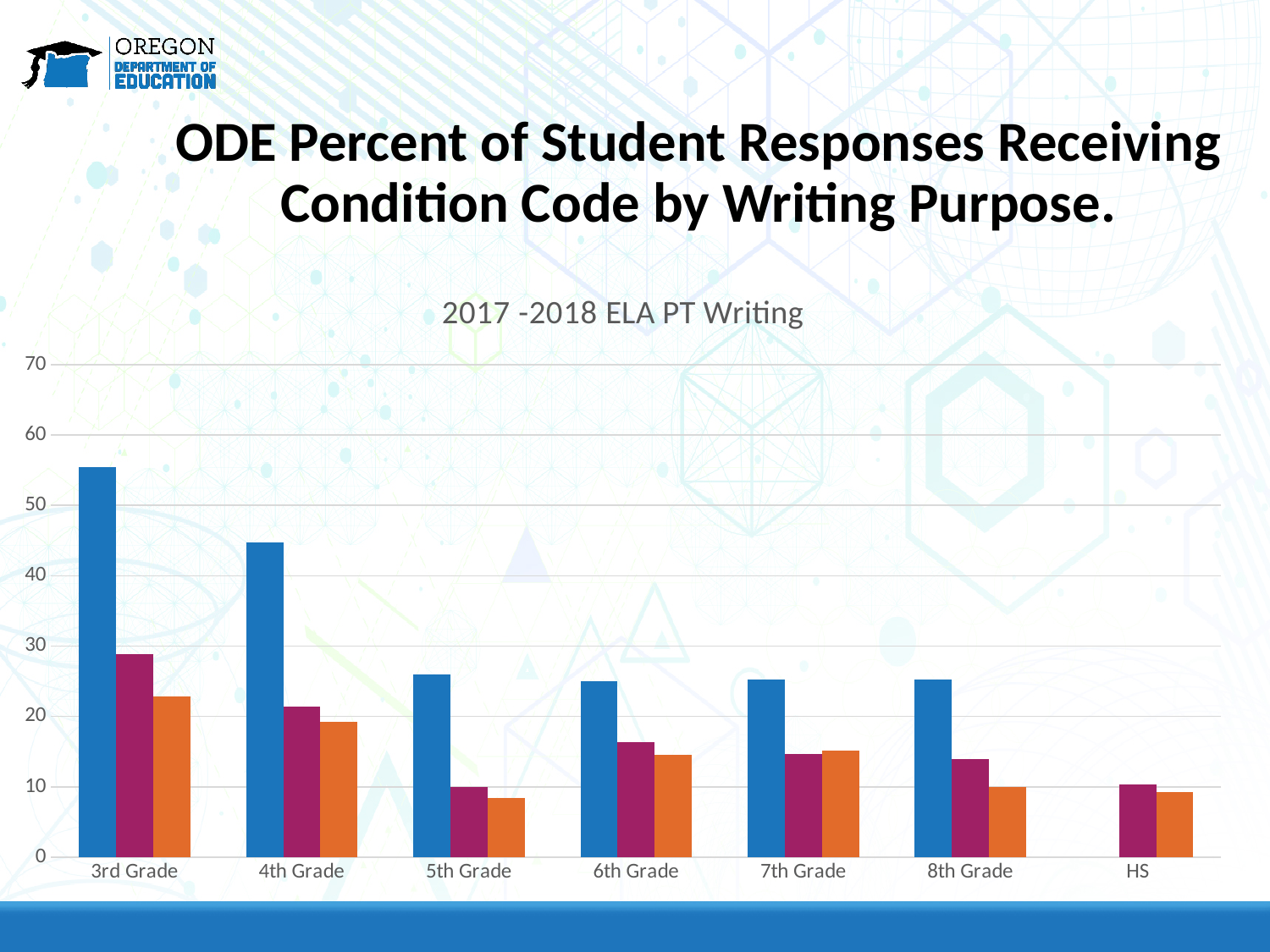
Do the blue bars rise or fall from 3rd Grade to 5th Grade? fall Is the value of the blue bar for 4th Grade greater or less than 40? greater Is the value of the blue bar for 3rd Grade greater or less than 50? greater Which category has no blue bar? HS Is the value of the orange bar for 3rd Grade greater or less than 20? greater What kind of chart is shown on the slide? bar chart What is the subtitle shown above the chart? 2017 -2018 ELA PT Writing How many grade categories are shown on the x axis? 7 Which is larger, the blue bar for 3rd Grade or the blue bar for 4th Grade? 3rd Grade For 8th Grade, which is larger, the magenta bar or the orange bar? the magenta bar Which grade has the tallest blue bar? 3rd Grade